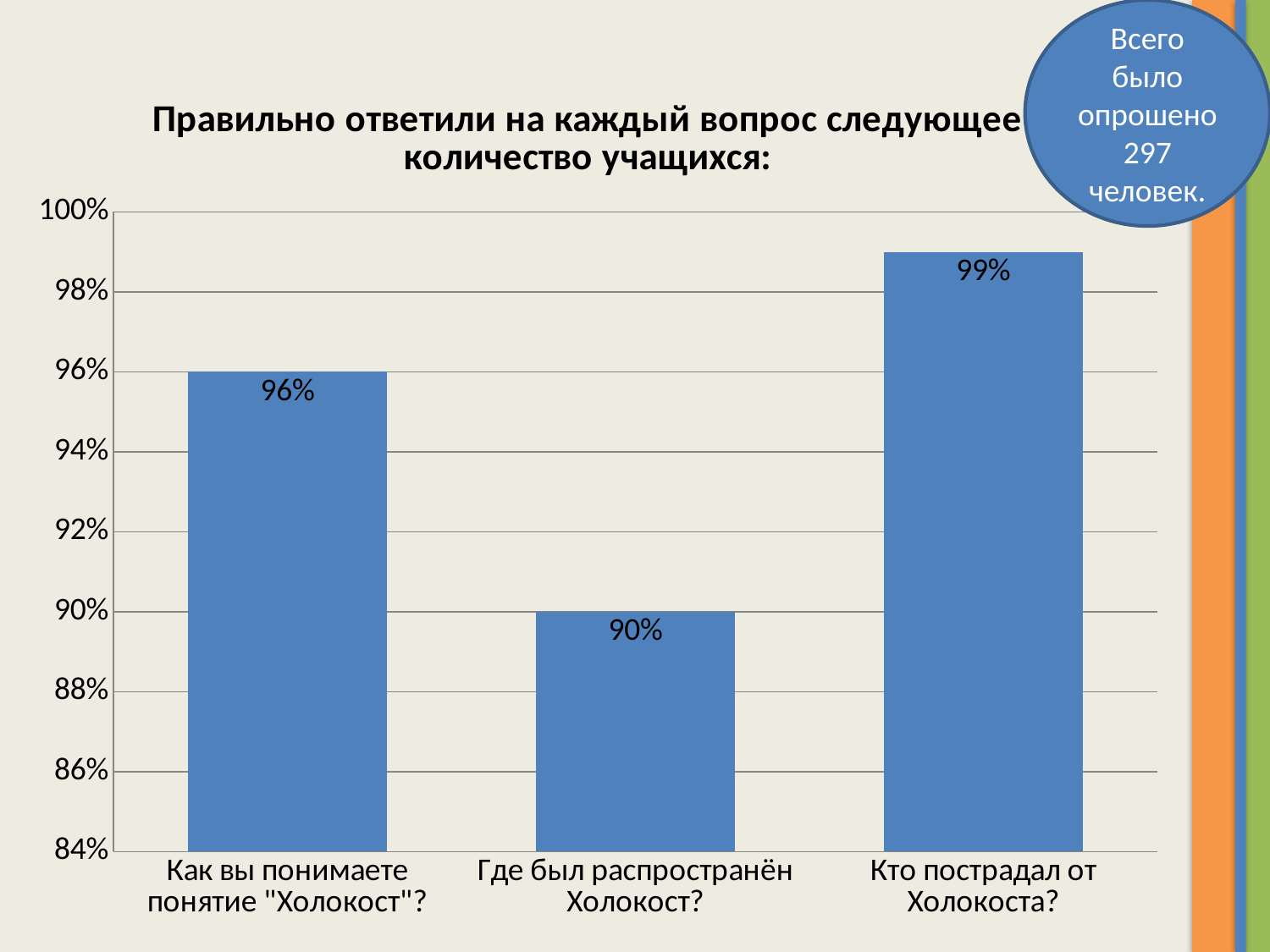
Which question has the lowest share of correct answers? Где был распространён Холокост? What is the difference between the values for "Как вы понимаете понятие "Холокост"?" and "Где был распространён Холокост?"? 6% What percentage of students correctly answered the question "Где был распространён Холокост?"? 90% What percentage of students correctly answered the question "Кто пострадал от Холокоста?"? 99% What is the title of the chart? Правильно ответили на каждый вопрос следующее количество учащихся: How many questions (categories) are shown in the chart? 3 Which question has the highest share of correct answers? Кто пострадал от Холокоста? Which is larger: the value for "Как вы понимаете понятие "Холокост"?" or the value for "Кто пострадал от Холокоста?"? Кто пострадал от Холокоста? Is the value for "Где был распространён Холокост?" greater or less than 92%? less What type of chart is shown on the slide? bar chart What percentage of students correctly answered the question "Как вы понимаете понятие "Холокост"?"? 96% What is the difference between the values for "Кто пострадал от Холокоста?" and "Где был распространён Холокост?"? 9%